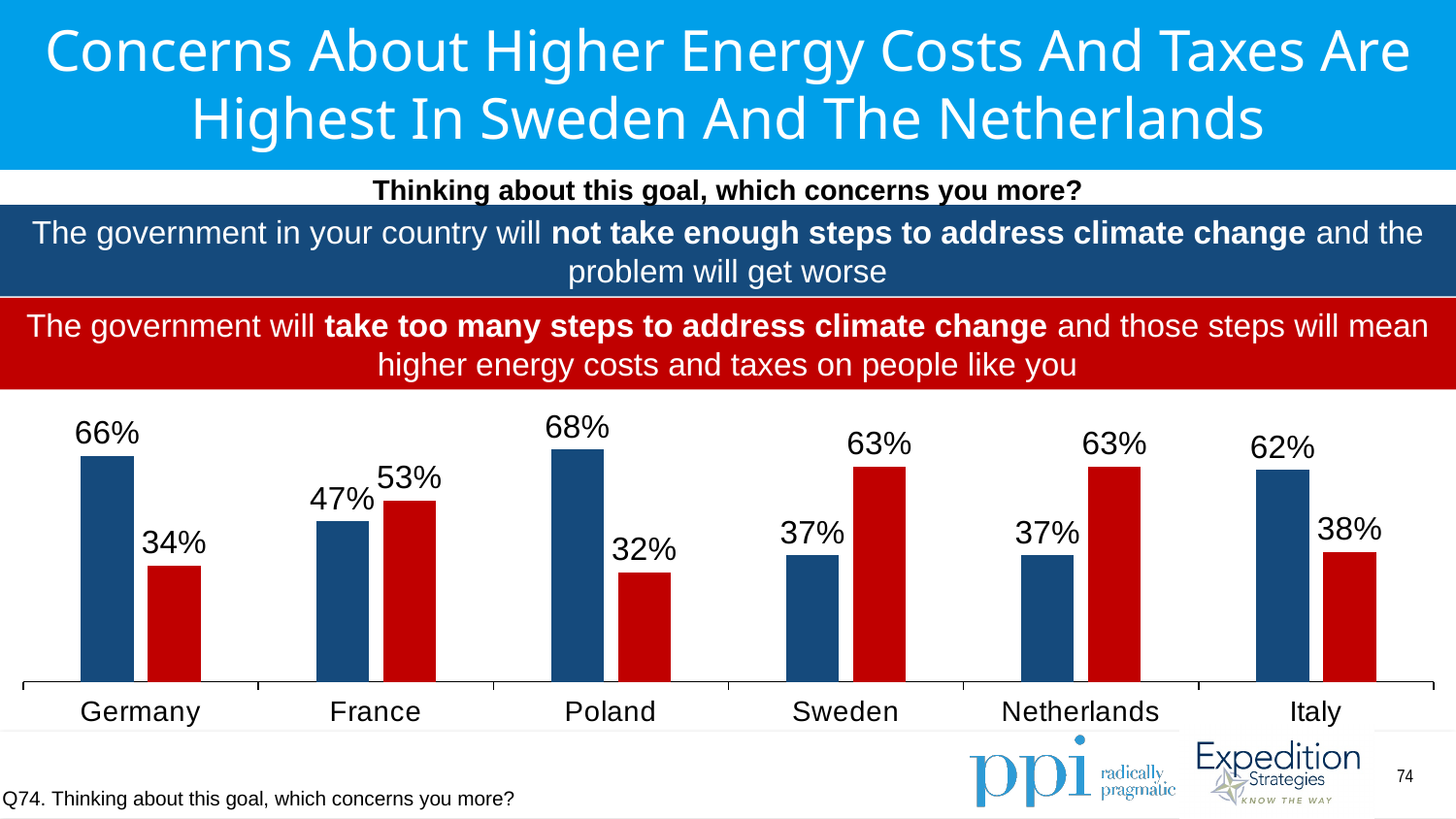
How many series (bar colours) does the chart show for each country? 2 What is the value of the blue bar (not take enough steps) for Italy? 62% In France, which is larger: the blue bar (not take enough steps) or the red bar (take too many steps)? The red bar (take too many steps) What percentage of respondents in Germany are more concerned that the government will not take enough steps to address climate change (blue bar)? 66% Which country has the highest value for the blue bar (not take enough steps)? Poland Which country has the lowest value for the red bar (take too many steps)? Poland What is the difference between the blue bar and the red bar for Germany? 32 percentage points What type of chart is shown on the slide? Bar chart How many countries are shown on the x axis of the chart? 6 What percentage of respondents in Sweden are more concerned that the government will take too many steps to address climate change (red bar)? 63% What is the total of the blue and red bars for the Netherlands? 100% What is the value of the red bar (take too many steps) for Poland? 32%